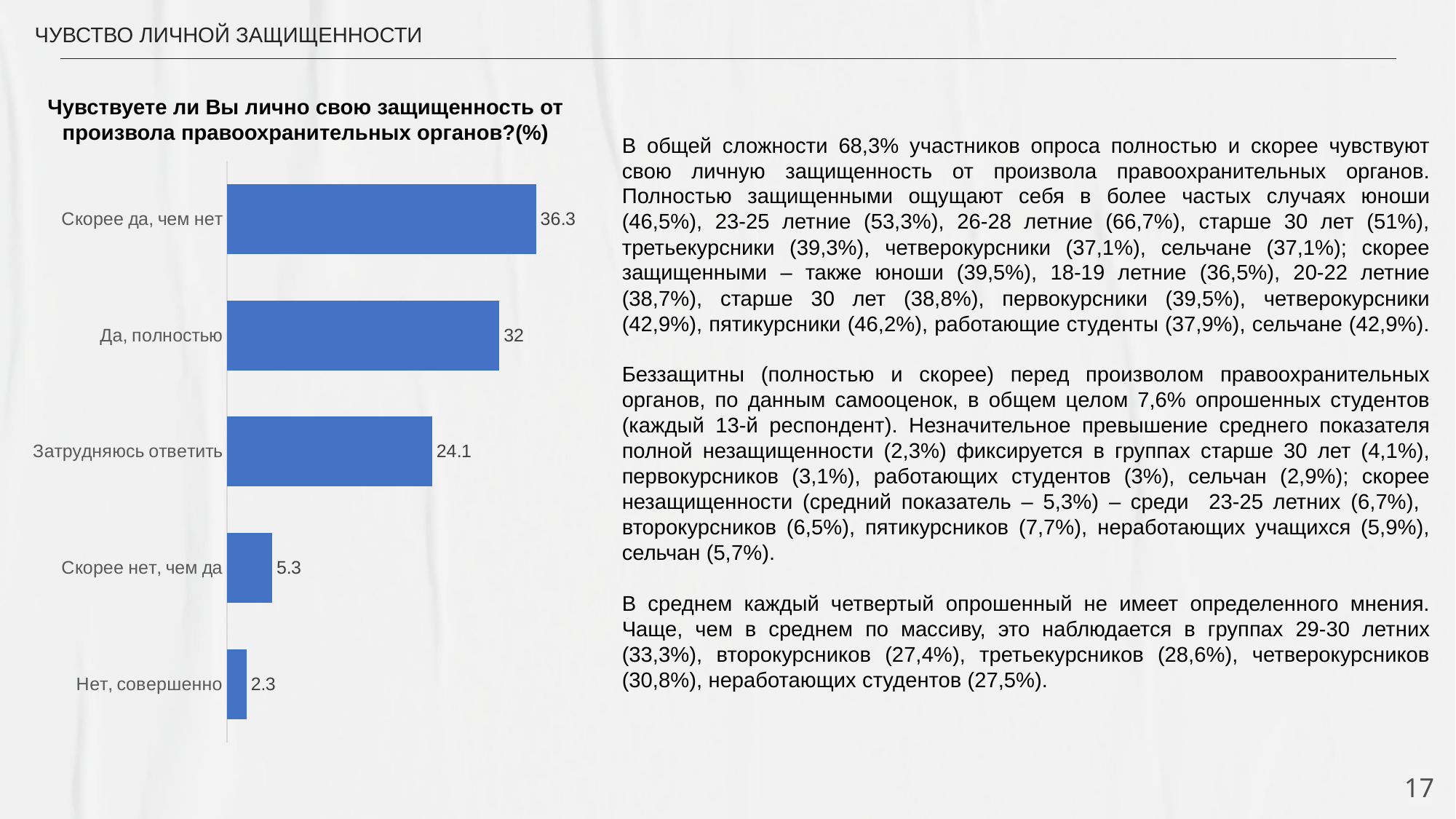
What kind of chart is shown on the slide? Bar chart Which category has the highest value? Скорее да, чем нет Which is larger: the value for "Затрудняюсь ответить" or the value for "Скорее нет, чем да"? Затрудняюсь ответить What is the title of the chart? Чувствуете ли Вы лично свою защищенность от произвола правоохранительных органов?(%) What is the value for "Нет, совершенно"? 2.3 Which category has the lowest value? Нет, совершенно What is the value for "Да, полностью"? 32 What is the value for "Затрудняюсь ответить"? 24.1 What is the value for "Скорее да, чем нет"? 36.3 How many categories are shown in the chart? 5 What is the difference between the values for "Скорее да, чем нет" and "Да, полностью"? 4.3 What is the difference between the values for "Скорее нет, чем да" and "Нет, совершенно"? 3